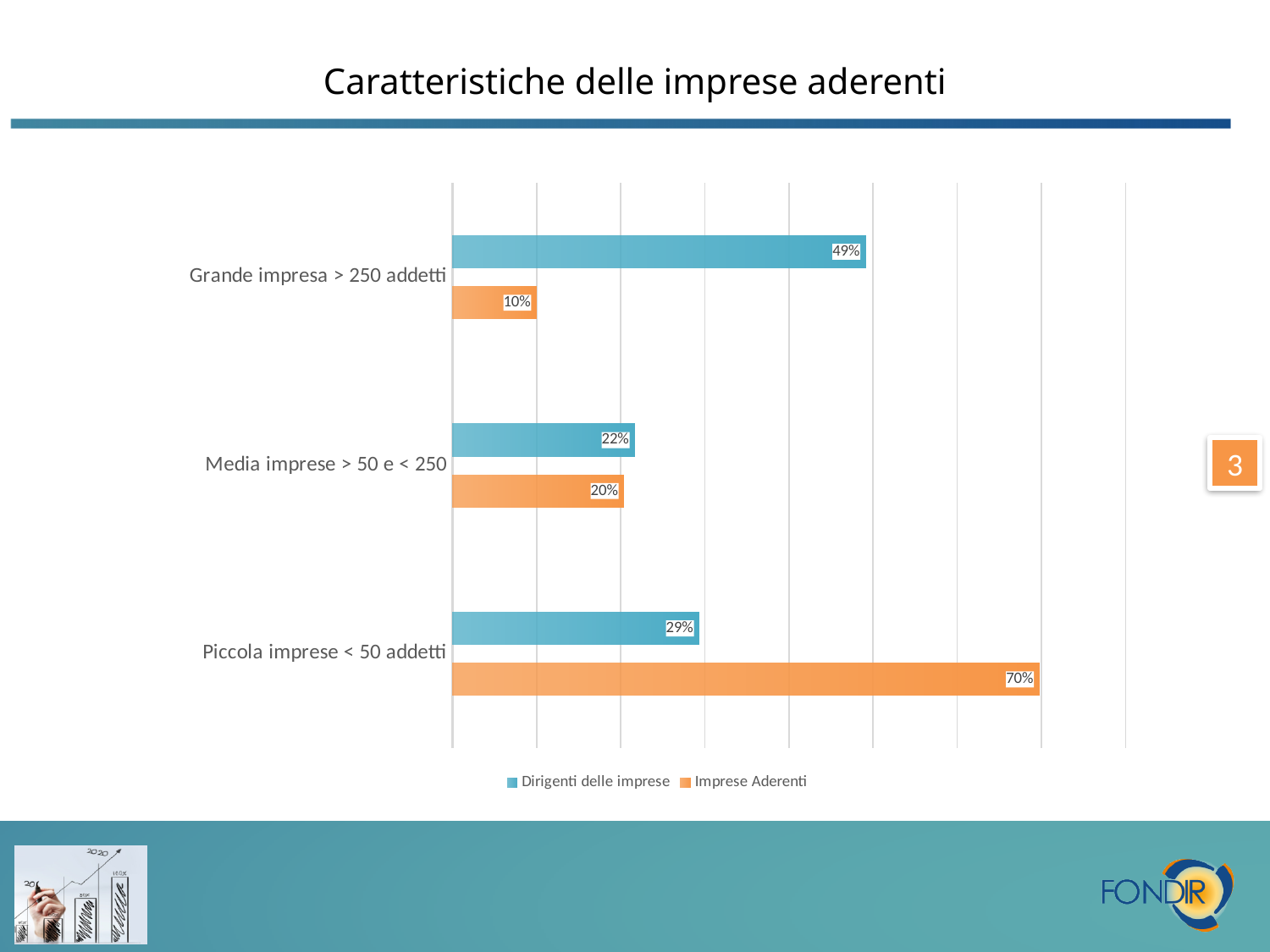
What is the value of Dirigenti delle imprese for Piccola imprese < 50 addetti? 29% What is the value of Imprese Aderenti for Media imprese > 50 e < 250? 20% What is the difference between Imprese Aderenti and Dirigenti delle imprese for Grande impresa > 250 addetti? 39% What is the value of Imprese Aderenti for Piccola imprese < 50 addetti? 70% How many series does the legend list? 2 What is the value of Dirigenti delle imprese for Grande impresa > 250 addetti? 49% Which is larger for Piccola imprese < 50 addetti: Dirigenti delle imprese or Imprese Aderenti? Imprese Aderenti What kind of chart is shown on the slide? Bar chart What is the title of the slide? Caratteristiche delle imprese aderenti Which category has the highest value for Imprese Aderenti? Piccola imprese < 50 addetti How many categories are shown on the chart? 3 Which category has the lowest value for Dirigenti delle imprese? Media imprese > 50 e < 250